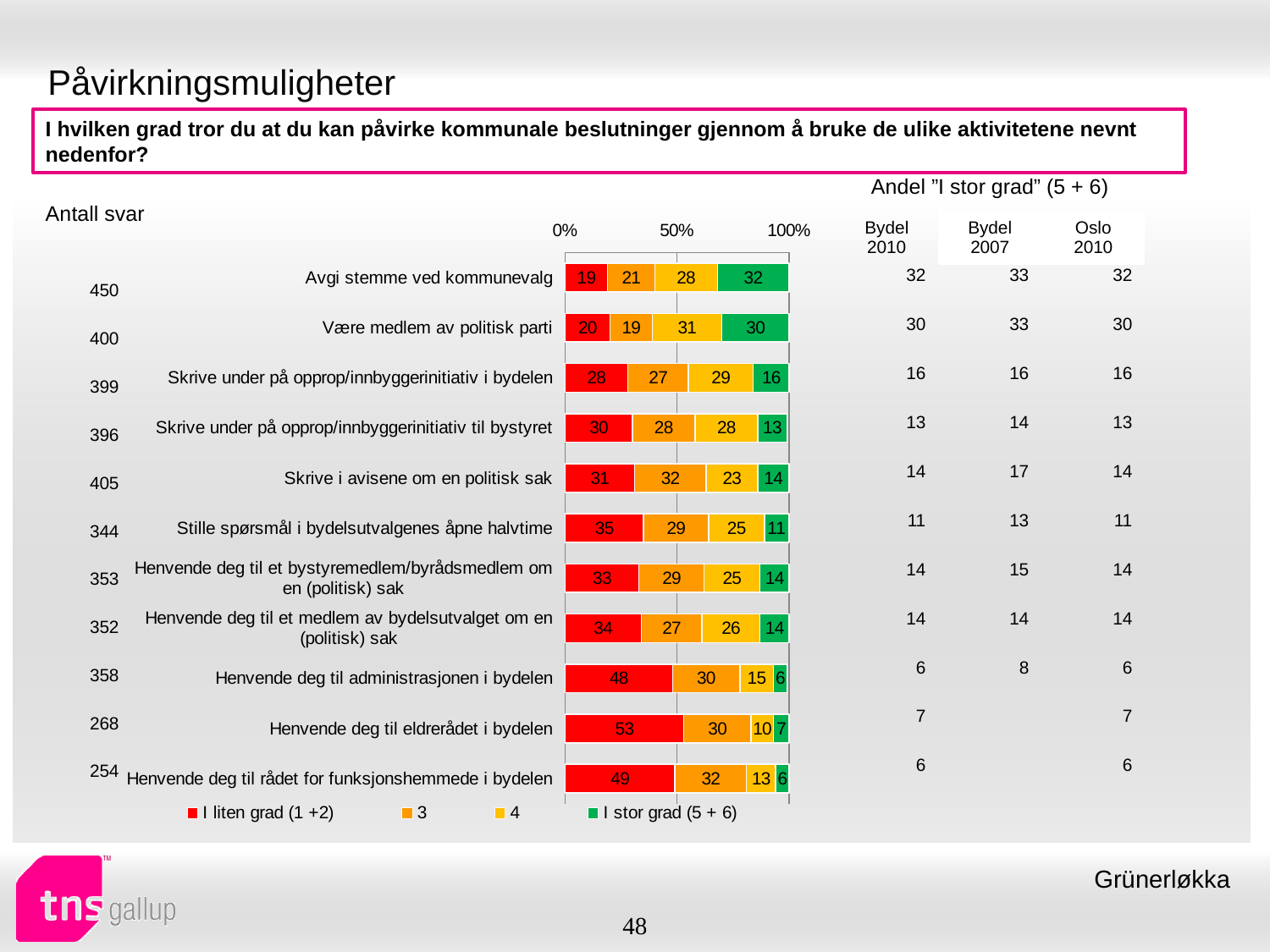
What is the value of series "3" for "Skrive i avisene om en politisk sak"? 32 Which is larger: the "I stor grad (5 + 6)" value for "Være medlem av politisk parti" or for "Skrive under på opprop/innbyggerinitiativ i bydelen"? Være medlem av politisk parti How many series does the chart legend list? 4 What kind of chart is shown on the slide? bar chart What is the difference between the "I liten grad (1 +2)" values for "Henvende deg til administrasjonen i bydelen" and "Avgi stemme ved kommunevalg"? 29 Which category has the highest value for "I liten grad (1 +2)"? Henvende deg til eldrerådet i bydelen Which colour represents "I stor grad (5 + 6)" in the chart? green What is the value of "I liten grad (1 +2)" for "Henvende deg til eldrerådet i bydelen"? 53 What is the total of the stacked bar for "Stille spørsmål i bydelsutvalgenes åpne halvtime"? 100 What is the value of "I stor grad (5 + 6)" for "Avgi stemme ved kommunevalg"? 32 How many categories (activities) are plotted in the chart? 11 Which category has the highest value for "I stor grad (5 + 6)"? Avgi stemme ved kommunevalg